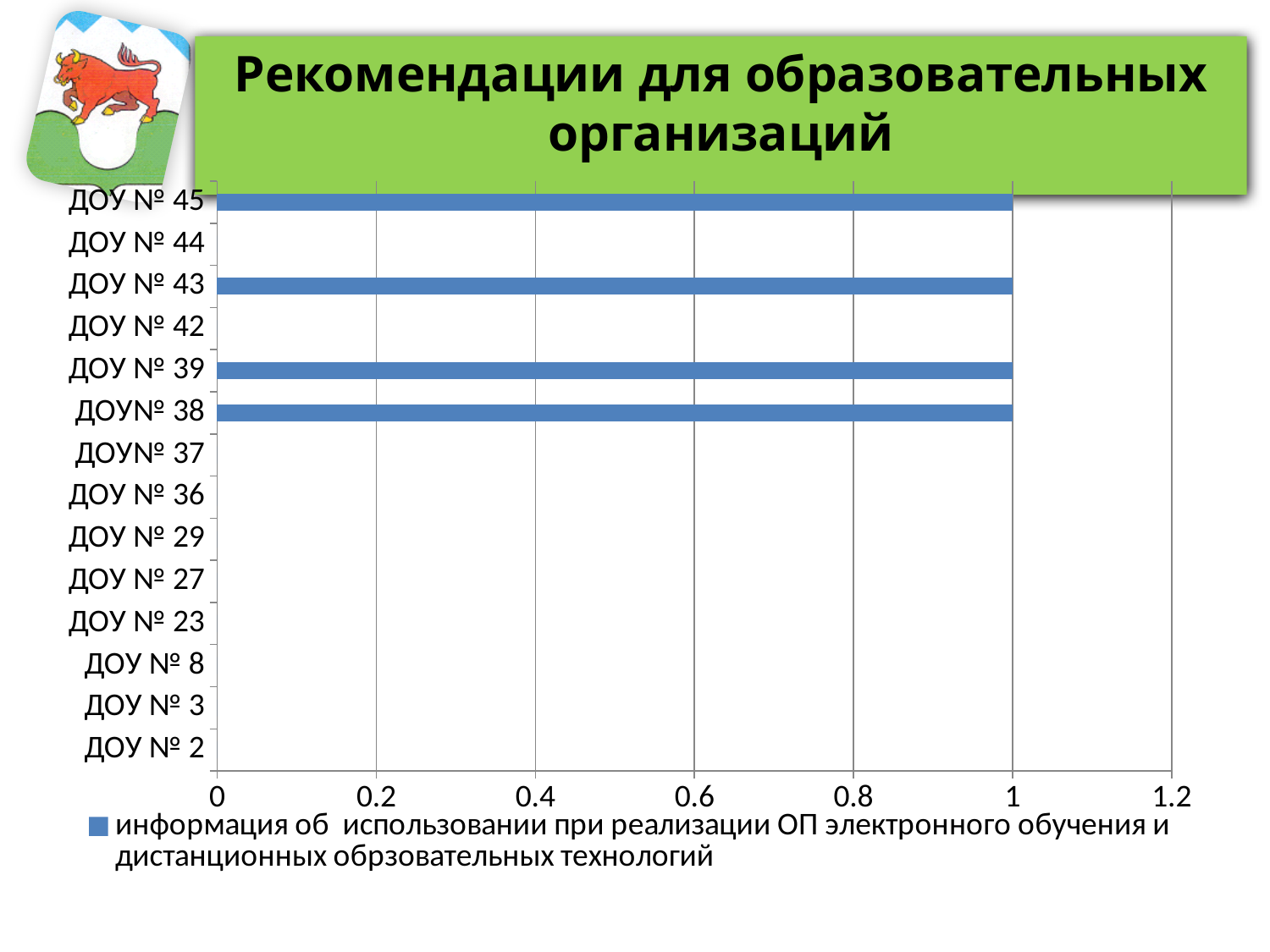
Is the value for ДОУ № 45 greater or less than 1.2? less Is the value for ДОУ № 39 greater or less than 0.8? greater What is the value for ДОУ № 39? 1 What kind of chart is shown on the slide? bar chart How many categories have a visible bar in the chart? 4 How many categories (ДОУ) are listed on the vertical axis of the chart? 14 What is the value for ДОУ№ 38? 1 How many series does the chart legend list? 1 What is the highest value shown on the horizontal axis of the chart? 1.2 What is the value for ДОУ № 43? 1 What is the value for ДОУ № 45? 1 Which is larger, the value for ДОУ № 43 or the value for ДОУ № 42? ДОУ № 43